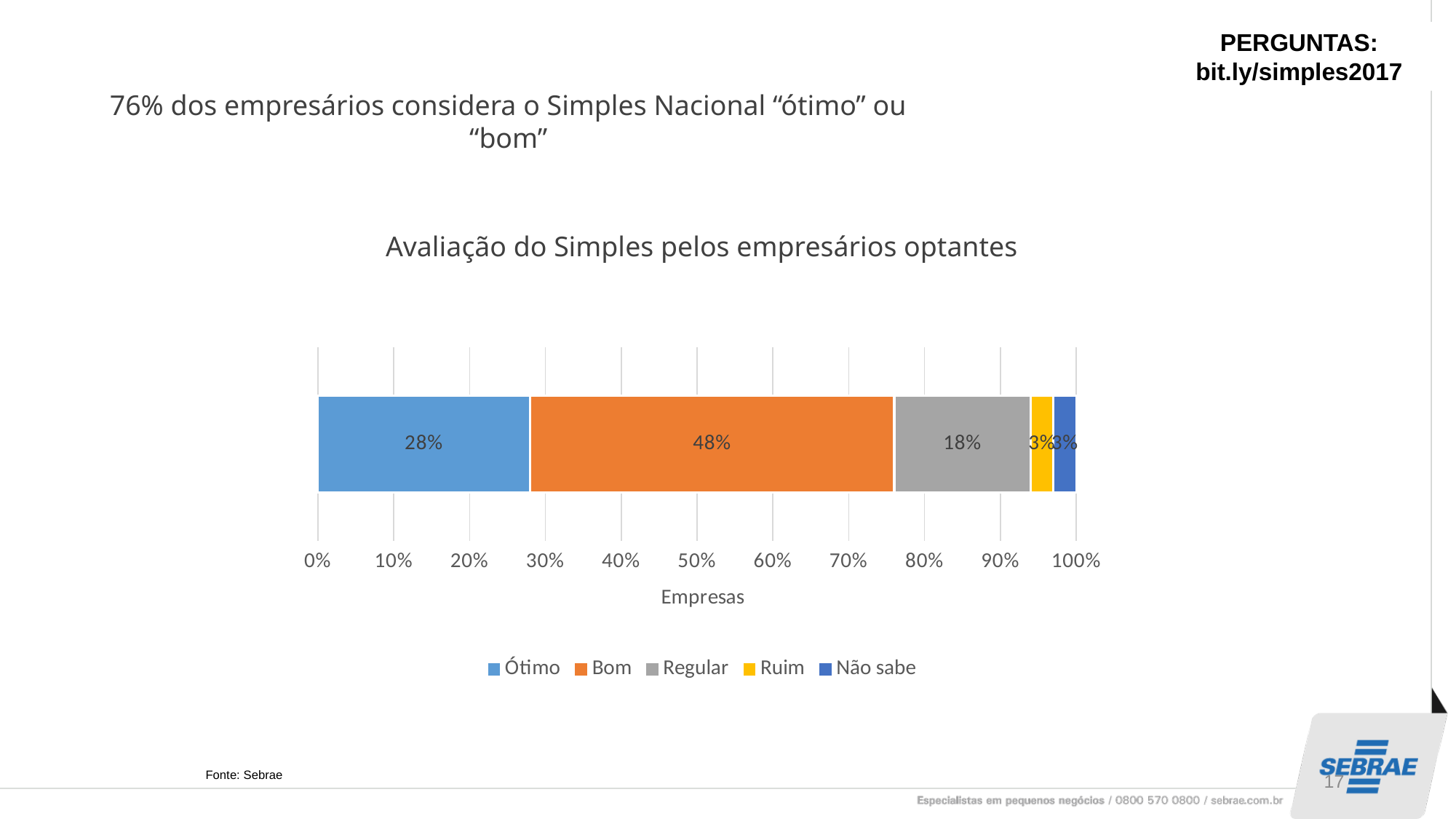
How many series does the legend list? 5 What percentage of companies rated the Simples as "Ótimo"? 28% What kind of chart is shown on the slide? Stacked bar chart What is the difference between the "Ótimo" and "Regular" shares? 10% What percentage of companies rated the Simples as "Regular"? 18% What is the difference between the "Bom" and "Ótimo" shares? 20% What is the title of the chart? Avaliação do Simples pelos empresários optantes Which is larger, the share for "Regular" or the share for "Ótimo"? Ótimo What is the combined share of "Ótimo" and "Bom"? 76% What percentage of companies rated the Simples as "Ruim"? 3% What percentage of companies rated the Simples as "Bom"? 48% Which rating category has the largest share? Bom